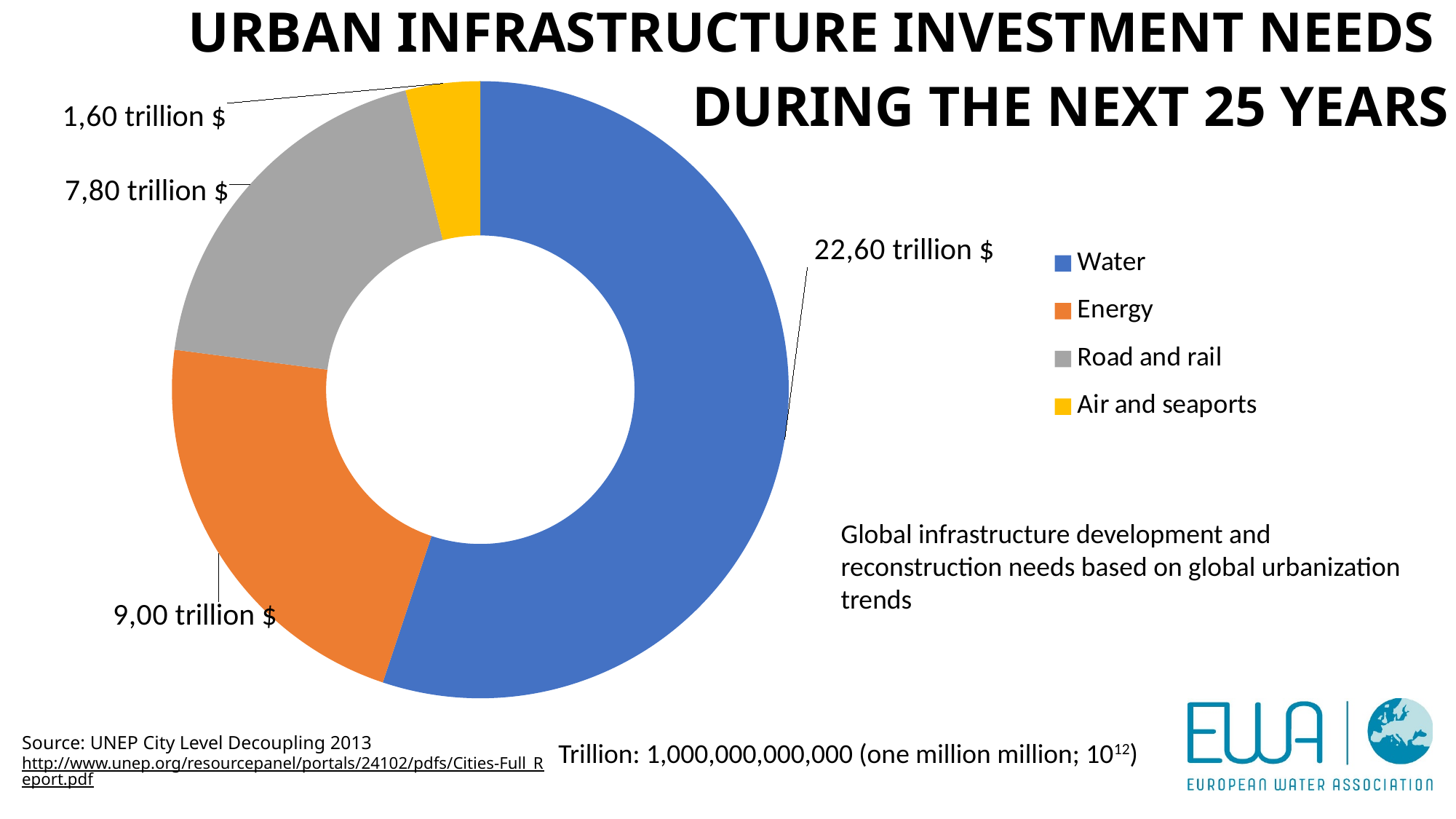
What colour represents Road and rail in the chart? Grey What is the difference between the investment needs for Road and rail and Air and seaports? 6,20 trillion $ What is the investment need for Air and seaports? 1,60 trillion $ Which category has the largest investment need? Water How many categories are shown in the chart? 4 What is the investment need for Energy? 9,00 trillion $ What kind of chart is shown on the slide? Doughnut (pie) chart Which has the larger investment need, Energy or Road and rail? Energy What is the investment need for Water? 22,60 trillion $ What is the investment need for Road and rail? 7,80 trillion $ How much larger is the investment need for Water than for Energy? 13,60 trillion $ Which category has the smallest investment need? Air and seaports